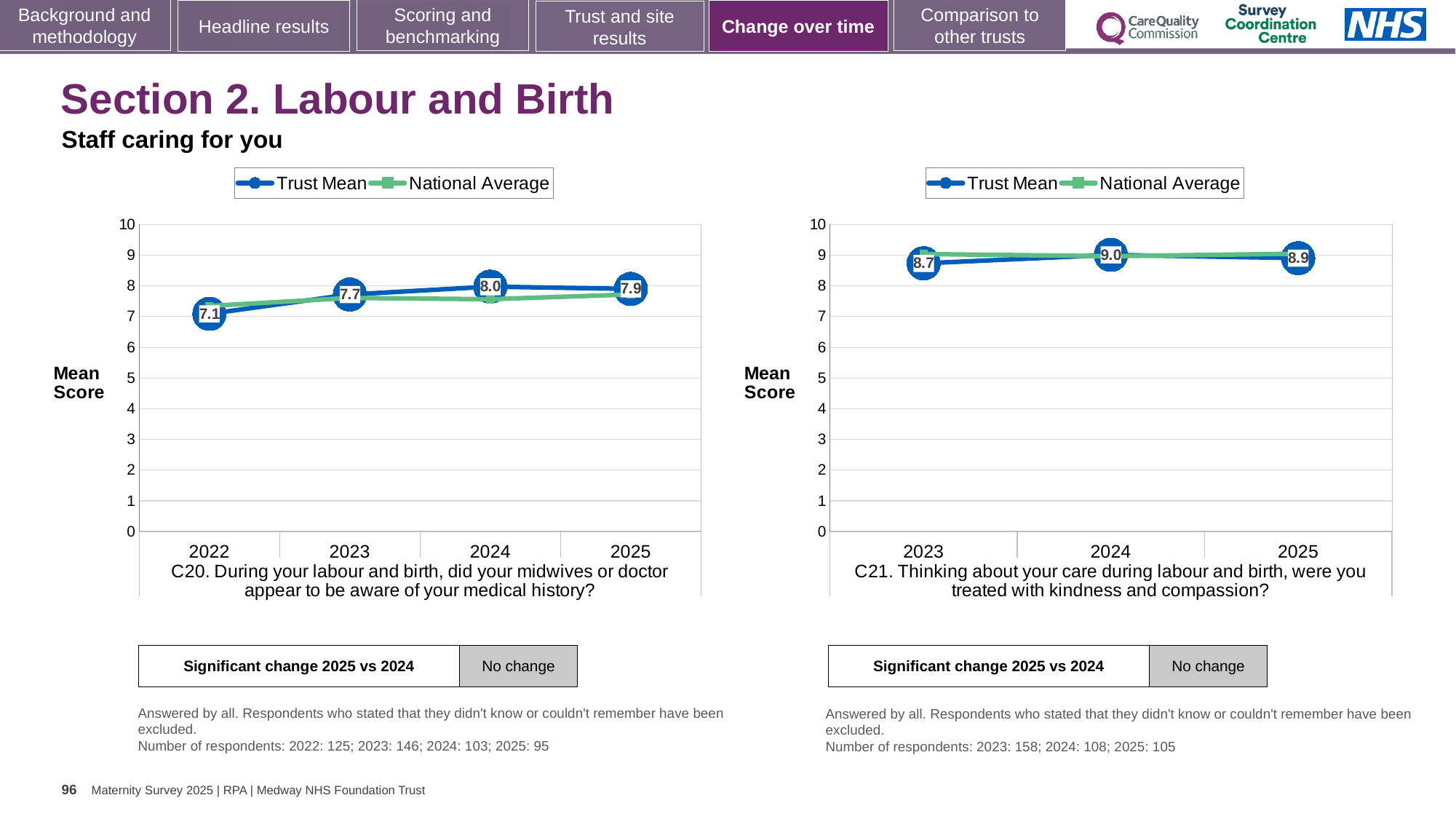
On the left chart (C20), what is the difference between the Trust Mean scores for 2025 and 2022? 0.8 On the left chart (C20), what is the Trust Mean score for 2024? 8.0 On the right chart (C21), what is the Trust Mean score for 2025? 8.9 How many series does the legend of the right chart (C21) list? 2 On the left chart (C20), which year has the lowest Trust Mean score? 2022 On the right chart (C21), which year has the lowest Trust Mean score? 2023 On the left chart (C20), which year has the highest Trust Mean score? 2024 On the right chart (C21), what is the Trust Mean score for 2024? 9.0 On the left chart (C20), what is the Trust Mean score for 2022? 7.1 What kind of chart is the left chart (C20)? Line chart How many years are plotted on the left chart (C20)? 4 On the right chart (C21), what is the difference between the Trust Mean scores for 2024 and 2023? 0.3